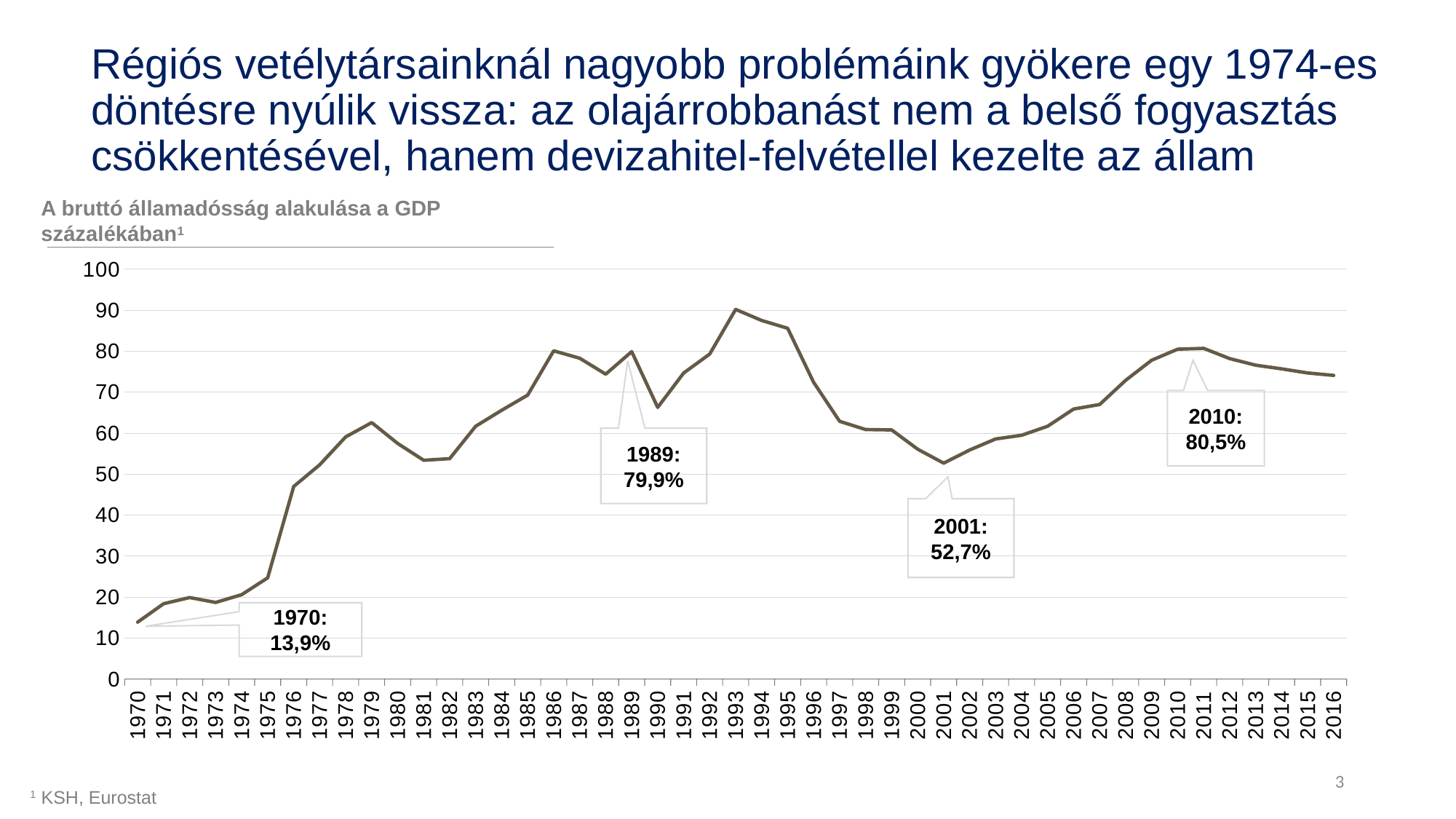
What is the value for 2010? 80,5% Which is larger, the value for 2010 or the value for 1989? 2010 Do the values rise or fall from 2010 to 2016? fall Which year has the highest value on the chart? 1993 What kind of chart is shown on the slide? line chart What is the difference between the values for 2010 and 1970? 66,6 percentage points Is the value for 1975 greater or less than 30? less Is the value for 1993 greater or less than 80? greater Which year has the lowest value on the chart? 1970 What is the value for 2001? 52,7% What is the value for 1989? 79,9% What is the value for 1970? 13,9%